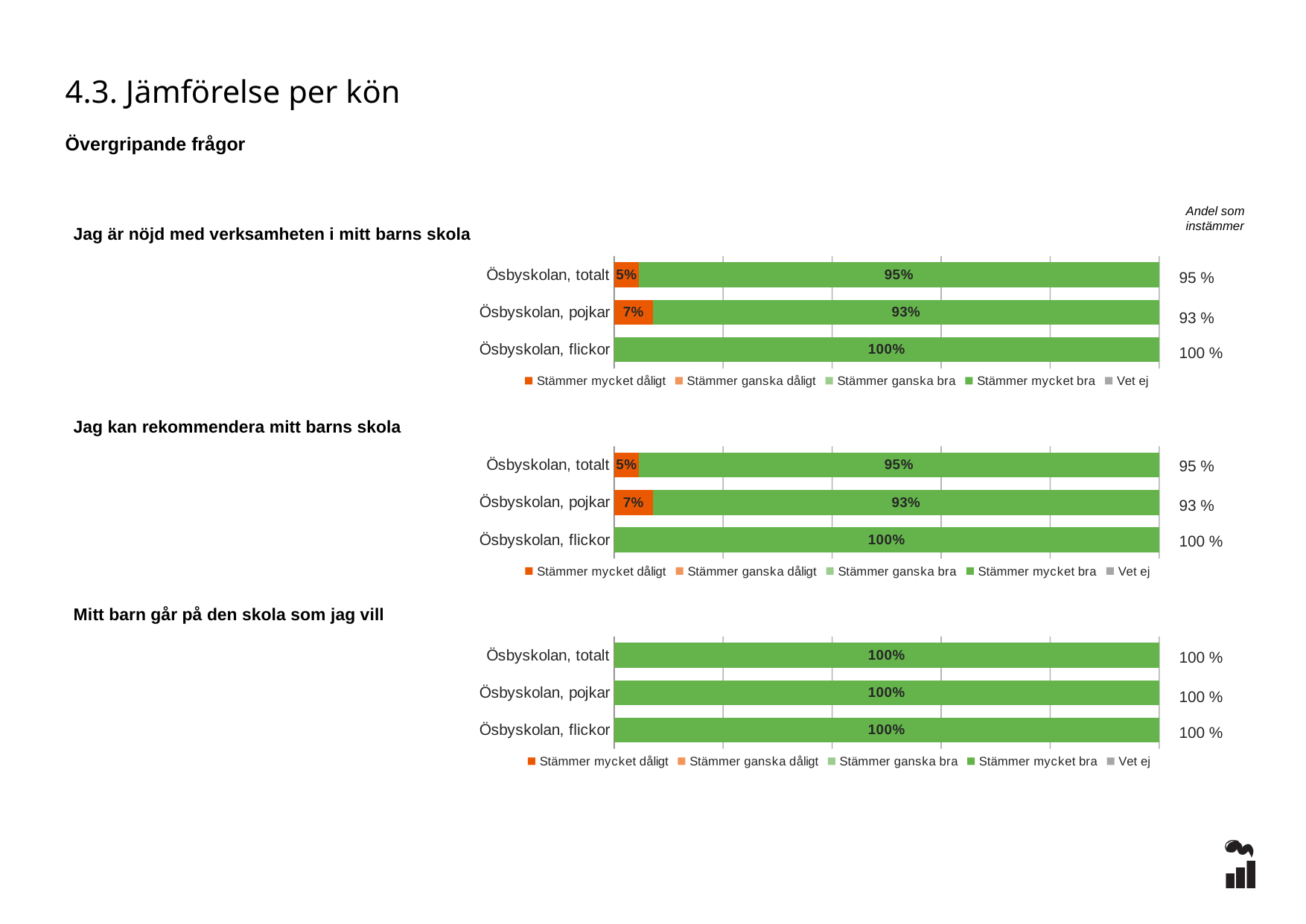
In the chart 'Mitt barn går på den skola som jag vill', what is the 'Stämmer mycket bra' value for Ösbyskolan, totalt? 100% How many series does the legend list in the chart 'Jag kan rekommendera mitt barns skola'? 5 What kind of chart is 'Mitt barn går på den skola som jag vill'? Stacked bar chart In the chart 'Jag är nöjd med verksamheten i mitt barns skola', what is the 'Andel som instämmer' value shown for Ösbyskolan, pojkar? 93 % How many categories are shown in the chart 'Mitt barn går på den skola som jag vill'? 3 In the chart 'Jag är nöjd med verksamheten i mitt barns skola', what is the 'Stämmer mycket dåligt' value for Ösbyskolan, totalt? 5% In the chart 'Jag kan rekommendera mitt barns skola', what is the difference between the 'Stämmer mycket bra' values for Ösbyskolan, flickor and Ösbyskolan, pojkar? 7% In the chart 'Jag är nöjd med verksamheten i mitt barns skola', which category has the lowest 'Stämmer mycket bra' value? Ösbyskolan, pojkar In the chart 'Jag kan rekommendera mitt barns skola', which category has the highest 'Stämmer mycket bra' value? Ösbyskolan, flickor In the chart 'Jag är nöjd med verksamheten i mitt barns skola', which is larger: the 'Stämmer mycket bra' value for Ösbyskolan, totalt or for Ösbyskolan, pojkar? Ösbyskolan, totalt In the chart 'Jag kan rekommendera mitt barns skola', what is the 'Stämmer mycket dåligt' value for Ösbyskolan, pojkar? 7% In the chart 'Jag är nöjd med verksamheten i mitt barns skola', what is the 'Stämmer mycket bra' value for Ösbyskolan, pojkar? 93%